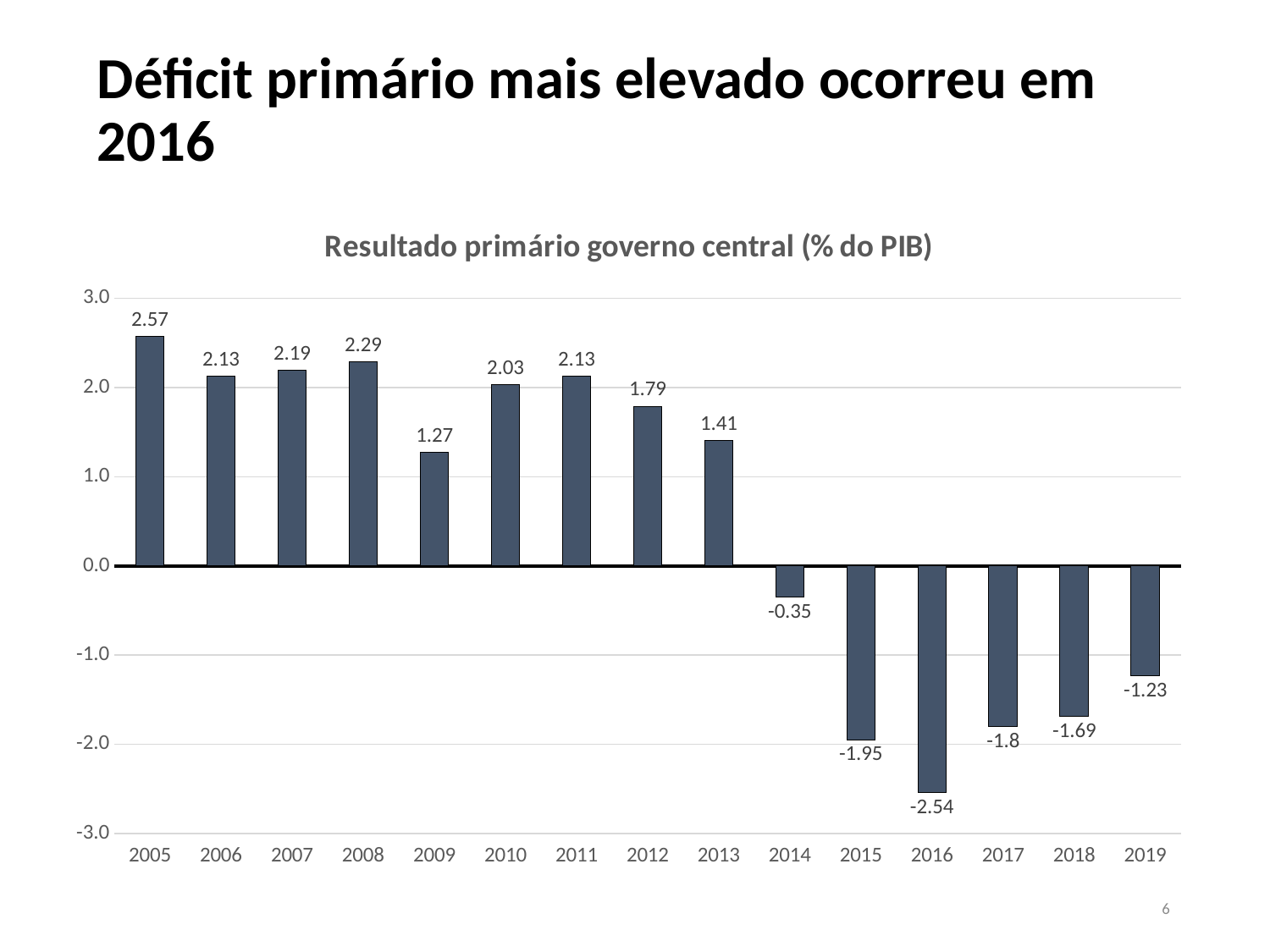
What is the value for 2014? -0.35 Which year has the highest value? 2005 What is the difference between the values for 2008 and 2009? 1.02 What is the value for 2016? -2.54 Which is larger, the value for 2010 or the value for 2012? 2010 What is the title of the chart? Resultado primário governo central (% do PIB) Is the value for 2013 greater or less than 1.0? greater Do the values generally rise or fall from 2005 to 2016? fall How many years are shown on the x axis? 15 What kind of chart is this? bar chart What is the value for 2005? 2.57 Which year has the lowest value? 2016